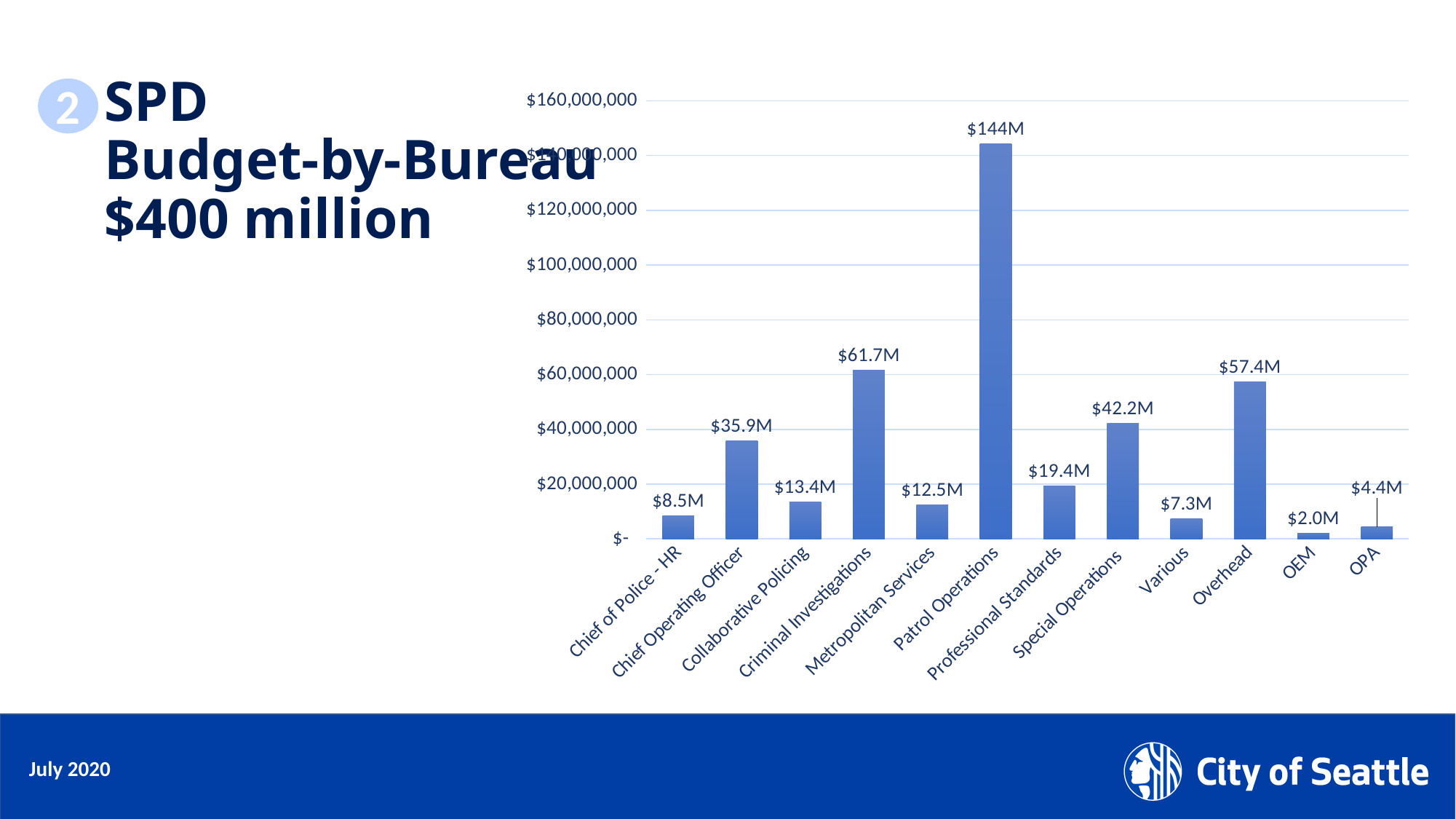
What is the budget value shown for Patrol Operations? $144M What is the difference between the budgets for Criminal Investigations and Overhead? $4.2M Is the value for Patrol Operations greater or less than $120,000,000? greater Which bureau has the lowest budget in the chart? OEM What is the budget value shown for Special Operations? $42.2M Which has a larger budget, Chief Operating Officer or Special Operations? Special Operations What is the budget value shown for Criminal Investigations? $61.7M How many bureaus are shown on the x axis of the chart? 12 Which bureau has the highest budget in the chart? Patrol Operations What kind of chart is shown on the slide? Bar chart What is the difference between the budgets for Patrol Operations and Criminal Investigations? $82.7M What is the budget value shown for OEM? $2.0M